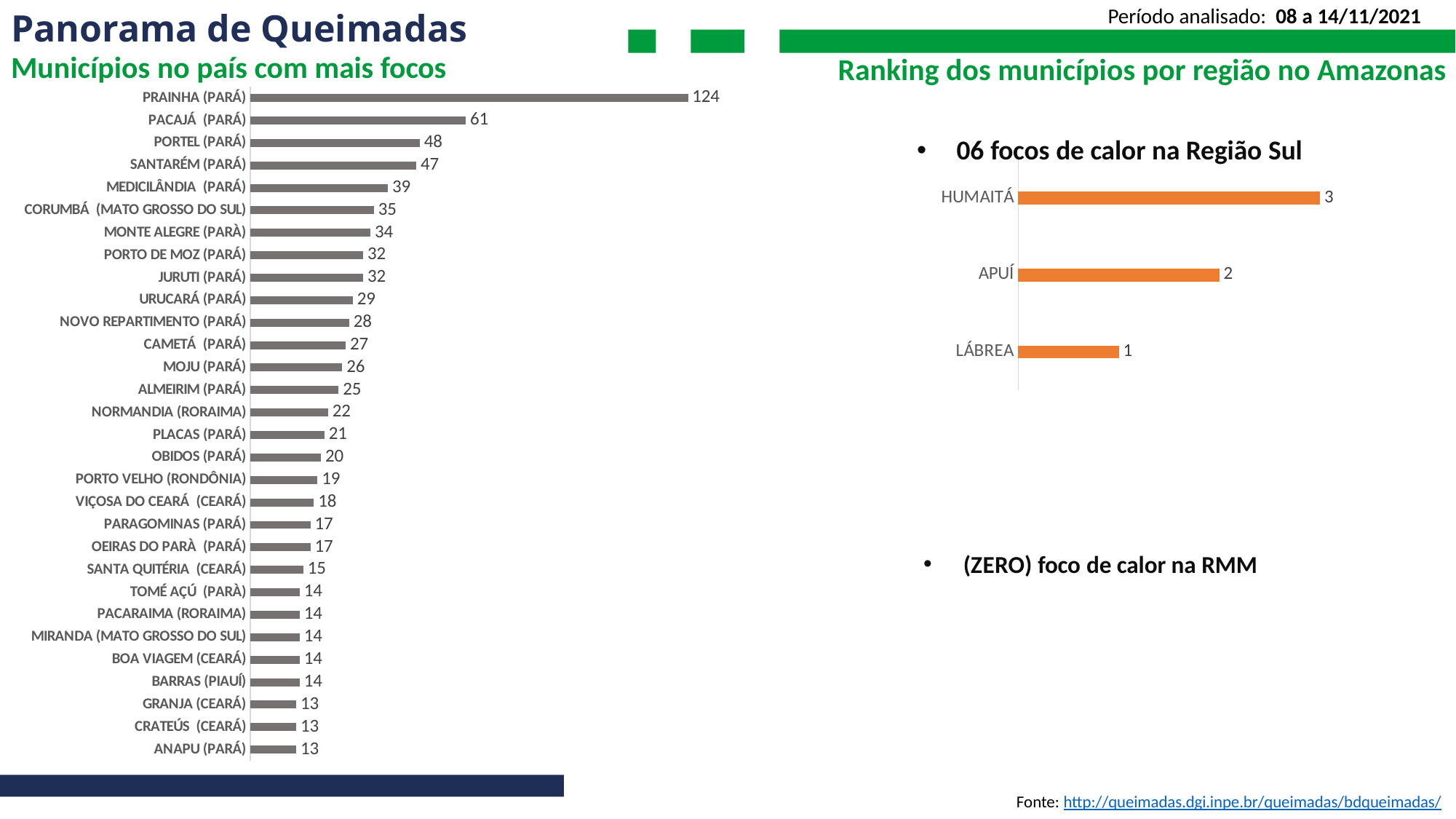
In the chart 'Municípios no país com mais focos', which is larger, the value for SANTARÉM (PARÁ) or the value for MEDICILÂNDIA (PARÁ)? SANTARÉM (PARÁ) How many municipalities are shown in the chart on the right ('06 focos de calor na Região Sul')? 3 In the chart on the right ('06 focos de calor na Região Sul'), which municipality has the lowest value? LÁBREA What colour are the bars in the chart on the right ('06 focos de calor na Região Sul')? Orange How many municipalities are listed in the chart 'Municípios no país com mais focos'? 30 In the chart on the right ('06 focos de calor na Região Sul'), what is the value for HUMAITÁ? 3 What kind of chart is 'Municípios no país com mais focos'? Bar chart In the chart 'Municípios no país com mais focos', what is the value for PORTO VELHO (RONDÔNIA)? 19 In the chart 'Municípios no país com mais focos', what is the value for CORUMBÁ (MATO GROSSO DO SUL)? 35 In the chart 'Municípios no país com mais focos', what is the value for PRAINHA (PARÁ)? 124 In the chart 'Municípios no país com mais focos', what is the difference between PRAINHA (PARÁ) and PACAJÁ (PARÁ)? 63 In the chart 'Municípios no país com mais focos', which municipality has the highest value? PRAINHA (PARÁ)